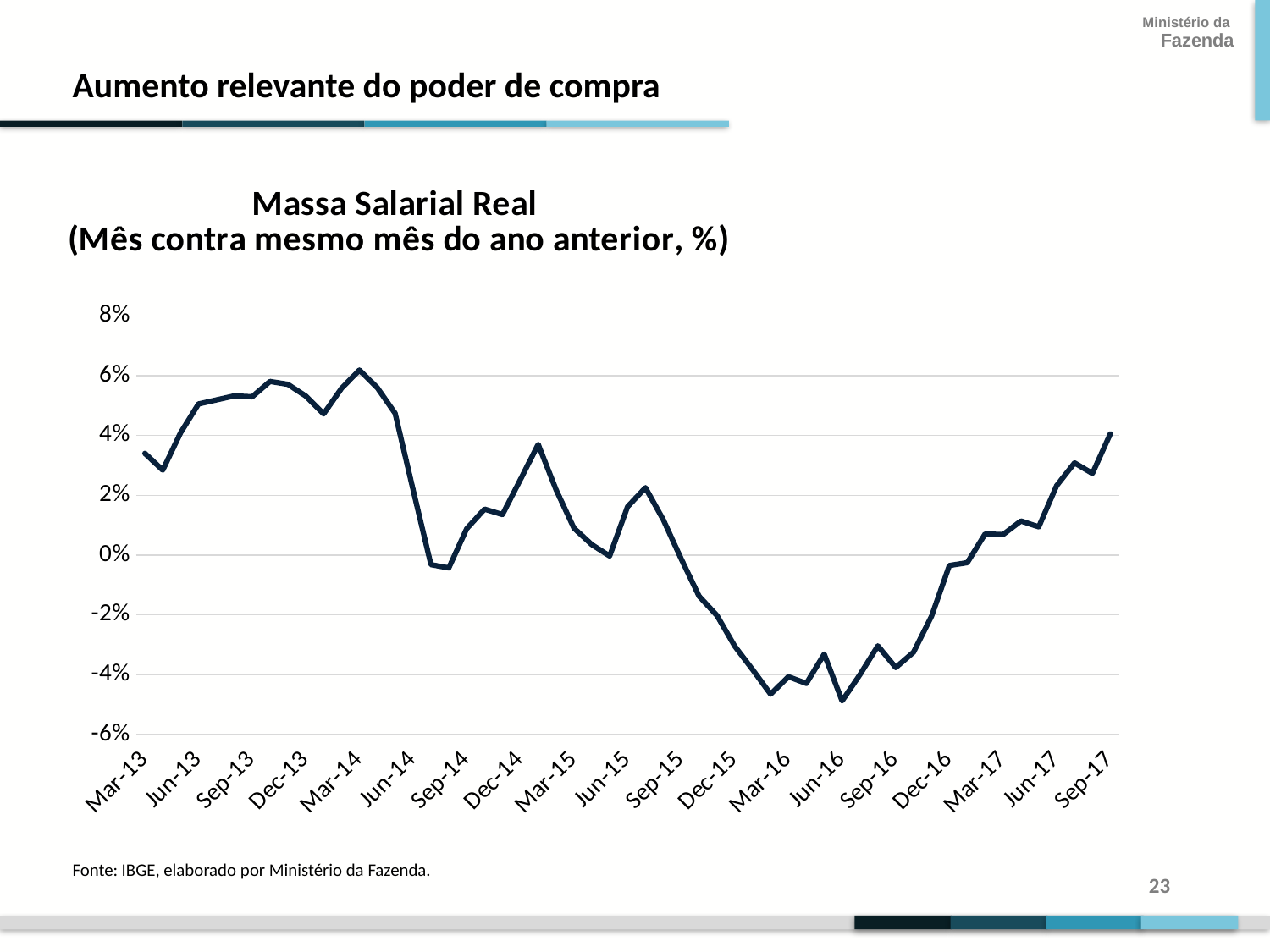
Is the value for Mar-13 greater or less than 2%? greater How many month labels are shown on the x axis? 19 What is the title of the chart? Massa Salarial Real (Mês contra mesmo mês do ano anterior, %) Is the value for Mar-14 greater or less than 4%? greater Does the line rise or fall between Jun-16 and Sep-17? rise Is the value for Sep-14 greater or less than 0%? greater Which is larger, the value for Mar-14 or the value for Jun-16? Mar-14 Which of the labelled months has the highest value on the chart? Mar-14 What kind of chart is shown on the slide? line chart Which of the labelled months has the lowest value on the chart? Jun-16